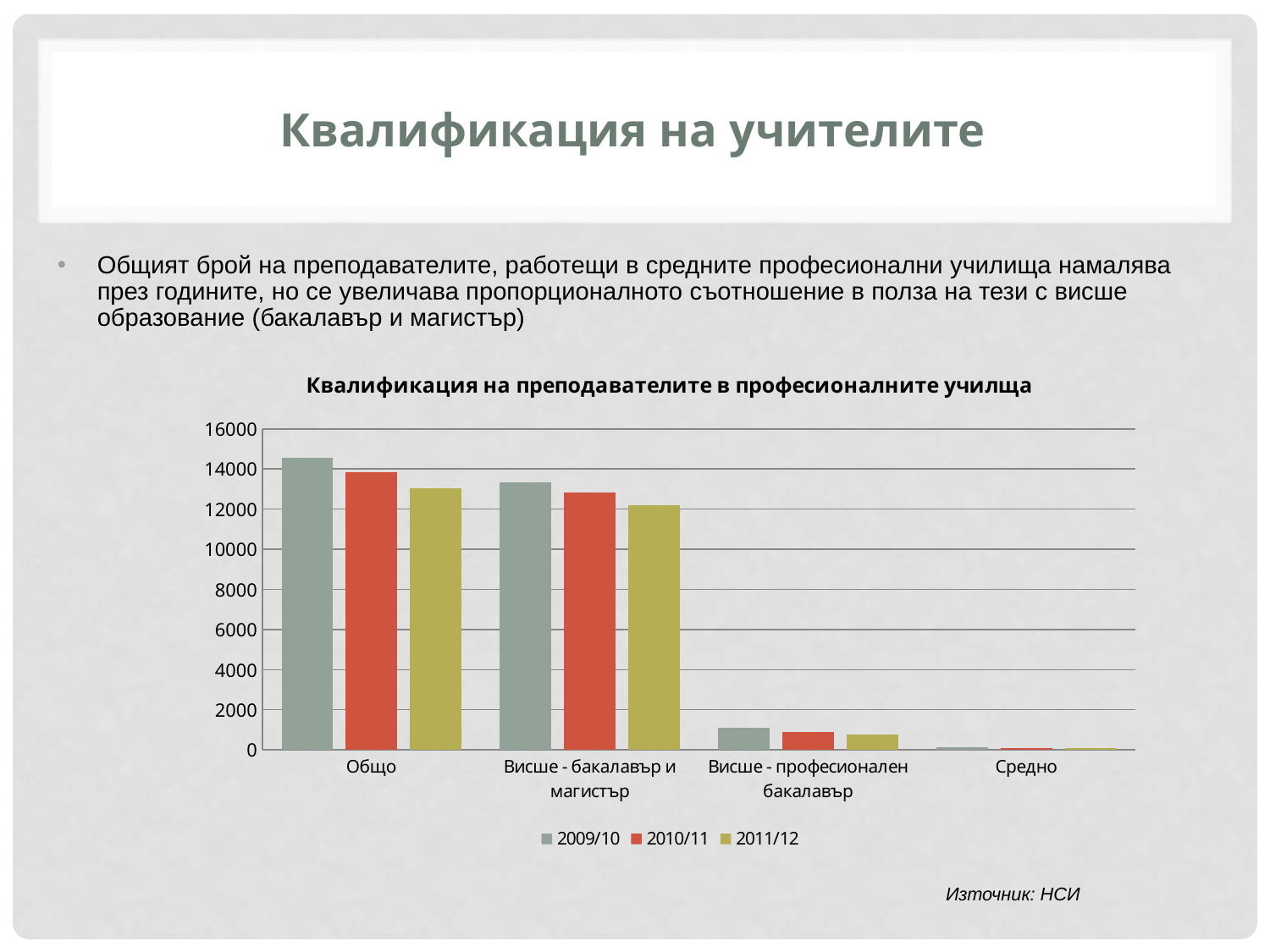
Is the 2009/10 value for Общо greater or less than 14000? greater What is the title of the chart? Квалификация на преподавателите в професионалните училща Which category has the lowest value for the 2011/12 series? Средно Is the 2009/10 value for Висше - професионален бакалавър greater or less than 2000? less For the category Общо, do the values rise or fall from 2009/10 to 2011/12? fall For the category Общо, which is larger: the 2009/10 value or the 2011/12 value? 2009/10 Which category has the highest value for the 2009/10 series? Общо Is the 2011/12 value for Общо greater or less than 14000? less How many categories are shown on the x axis of the chart? 4 What kind of chart is shown on the slide? bar chart How many series does the chart legend list? 3